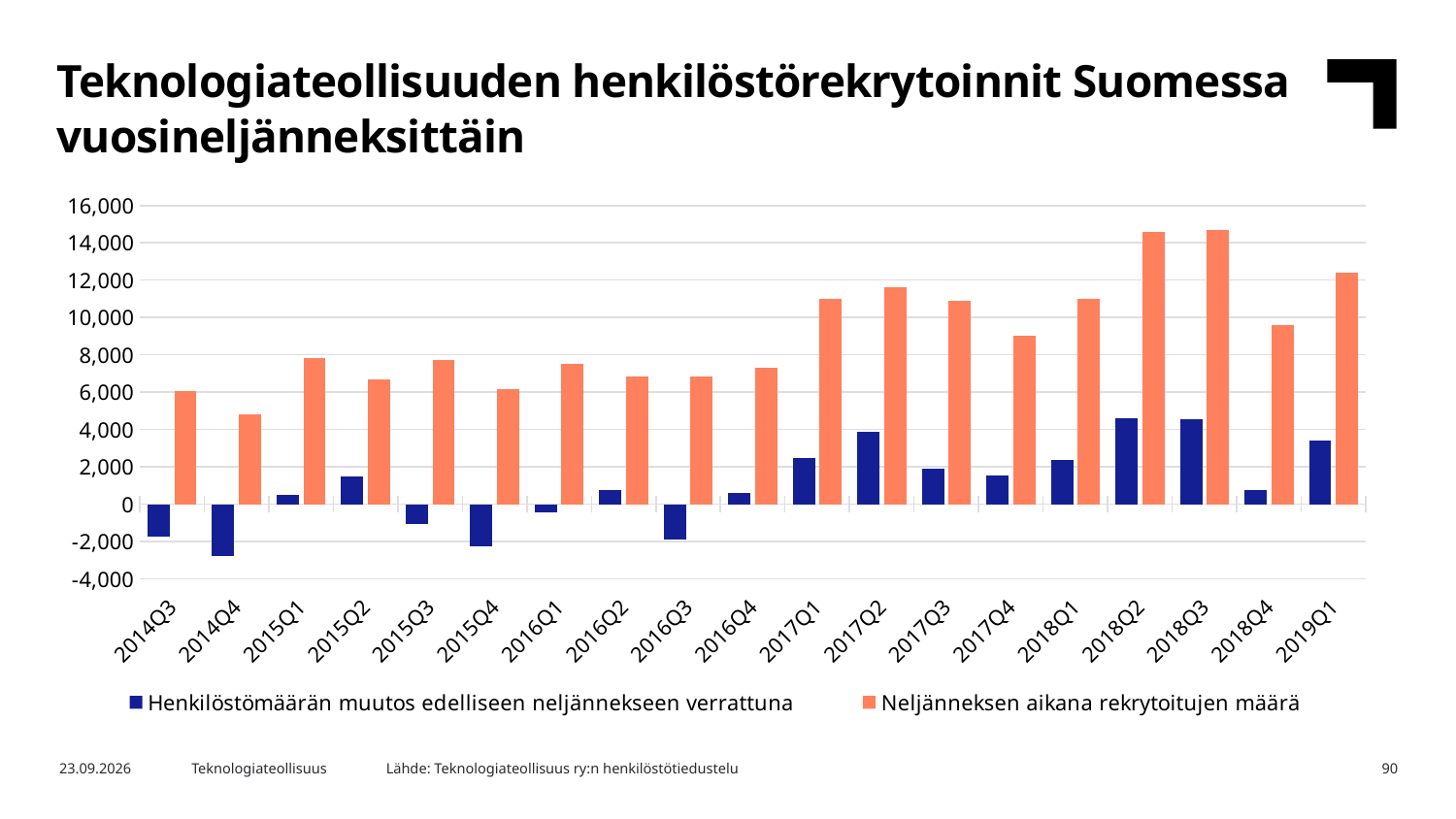
Is the value for 'Neljänneksen aikana rekrytoitujen määrä' in 2019Q1 greater or less than 10,000? greater Is the value for 'Henkilöstömäärän muutos edelliseen neljännekseen verrattuna' in 2017Q2 greater or less than 2,000? greater Is the value for 'Neljänneksen aikana rekrytoitujen määrä' in 2017Q4 greater or less than 10,000? less Which quarter has the lowest value for 'Neljänneksen aikana rekrytoitujen määrä'? 2014Q4 Which is larger for 'Neljänneksen aikana rekrytoitujen määrä': 2017Q1 or 2017Q2? 2017Q2 Which quarter has the lowest value for 'Henkilöstömäärän muutos edelliseen neljännekseen verrattuna'? 2014Q4 Which is larger for 'Neljänneksen aikana rekrytoitujen määrä': 2017Q4 or 2018Q4? 2018Q4 How many series does the legend list? 2 What kind of chart is shown on the slide? bar chart How many quarters are shown on the x axis? 19 Which colour represents 'Neljänneksen aikana rekrytoitujen määrä' in the chart? orange